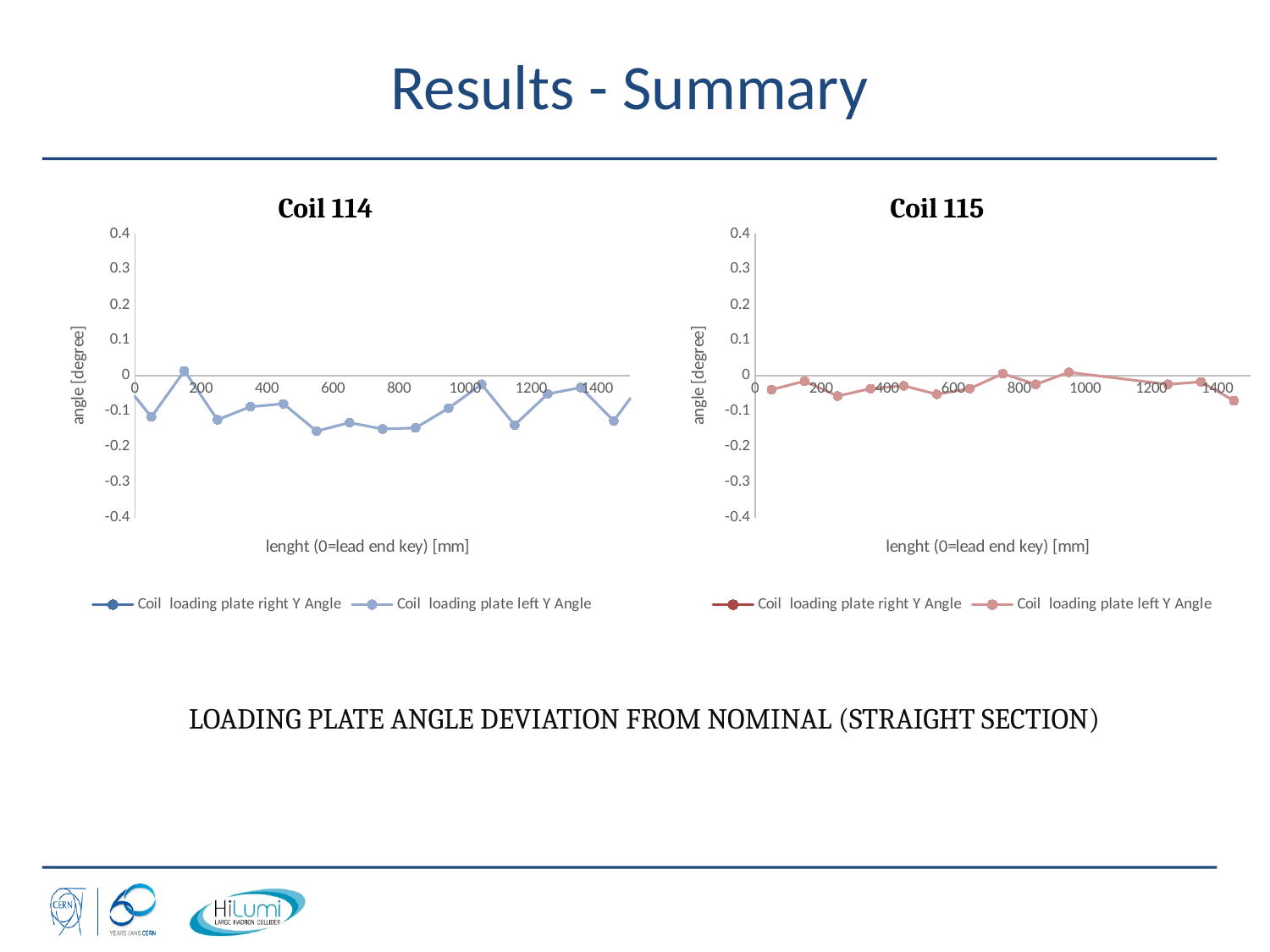
How many series does the legend of the Coil 114 chart list? 2 In the Coil 114 chart, is the value at about 560 mm greater or less than -0.1? less What kind of chart is the Coil 114 chart? line chart In the Coil 115 chart, is the value at about 260 mm greater or less than 0? less What is the y-axis label of the Coil 115 chart? angle [degree] What is the maximum value shown on the y axis of the Coil 114 chart? 0.4 In the Coil 115 chart, is the value at the last point (about 1460 mm) greater or less than 0? less What kind of chart is the Coil 115 chart? line chart How many series does the legend of the Coil 115 chart list? 2 In the Coil 114 chart, which is larger: the value at about 160 mm or the value at about 560 mm? the value at about 160 mm What is the title of the left chart? Coil 114